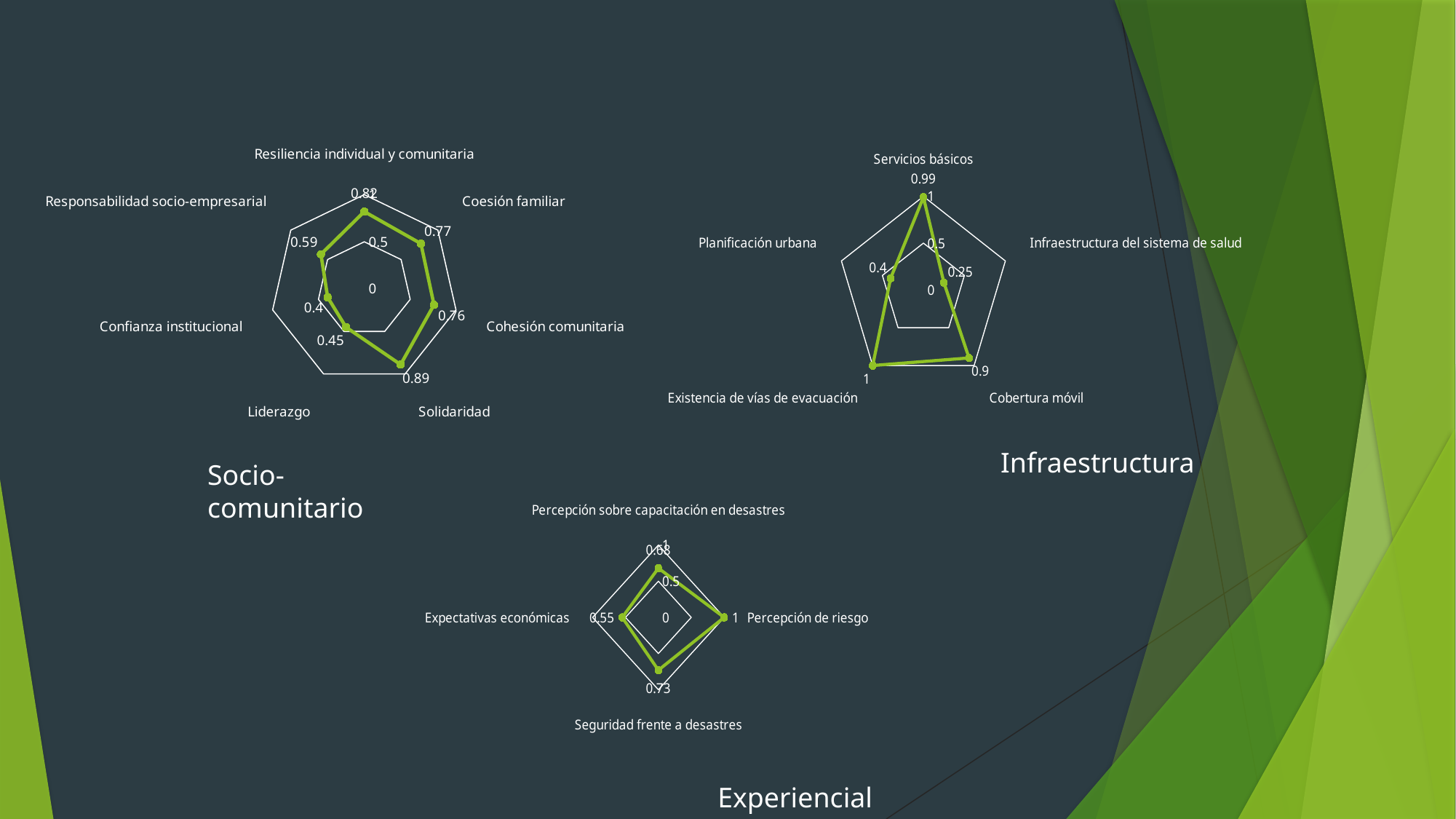
In the Infraestructura chart, which is larger: Cobertura móvil or Planificación urbana? Cobertura móvil How many categories does the Socio-comunitario radar chart have? 7 In the Experiencial chart, which category has the lowest value? Expectativas económicas In the Socio-comunitario chart, what is the value for Solidaridad? 0.89 In the Infraestructura chart, what is the value for Infraestructura del sistema de salud? 0.25 In the Socio-comunitario chart, which category has the highest value? Solidaridad In the Socio-comunitario chart, which category has the lowest value? Confianza institucional How many categories does the Experiencial chart have? 4 In the Experiencial chart, what is the value for Seguridad frente a desastres? 0.73 What type of chart is the Infraestructura chart? Radar chart In the Socio-comunitario chart, what is the difference between Resiliencia individual y comunitaria and Liderazgo? 0.37 In the Infraestructura chart, which category has the highest value? Existencia de vías de evacuación